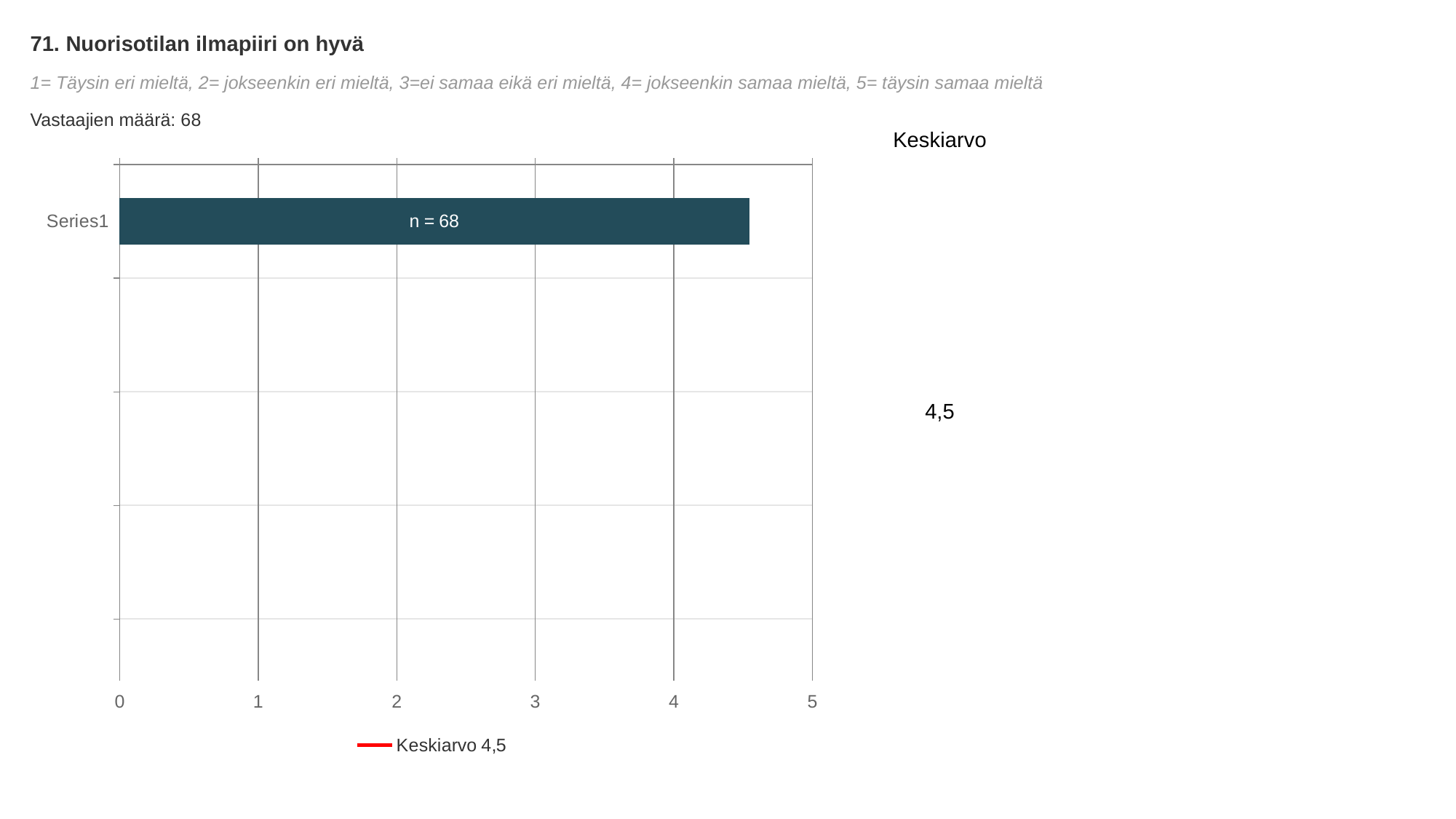
How many bars are plotted in the chart? 1 What does the legend entry below the chart say? Keskiarvo 4,5 What kind of chart is shown on the slide? bar chart Is the value of the Series1 bar greater or less than 5? less What is the category label of the single bar? Series1 Is the value of the Series1 bar greater or less than 4? greater What is the highest value shown on the horizontal axis? 5 What text label is printed on the bar? n = 68 What is the Keskiarvo (mean) value shown on the slide? 4,5 Is the value of the Series1 bar greater or less than 3? greater What is the number of respondents (Vastaajien määrä) stated on the slide? 68